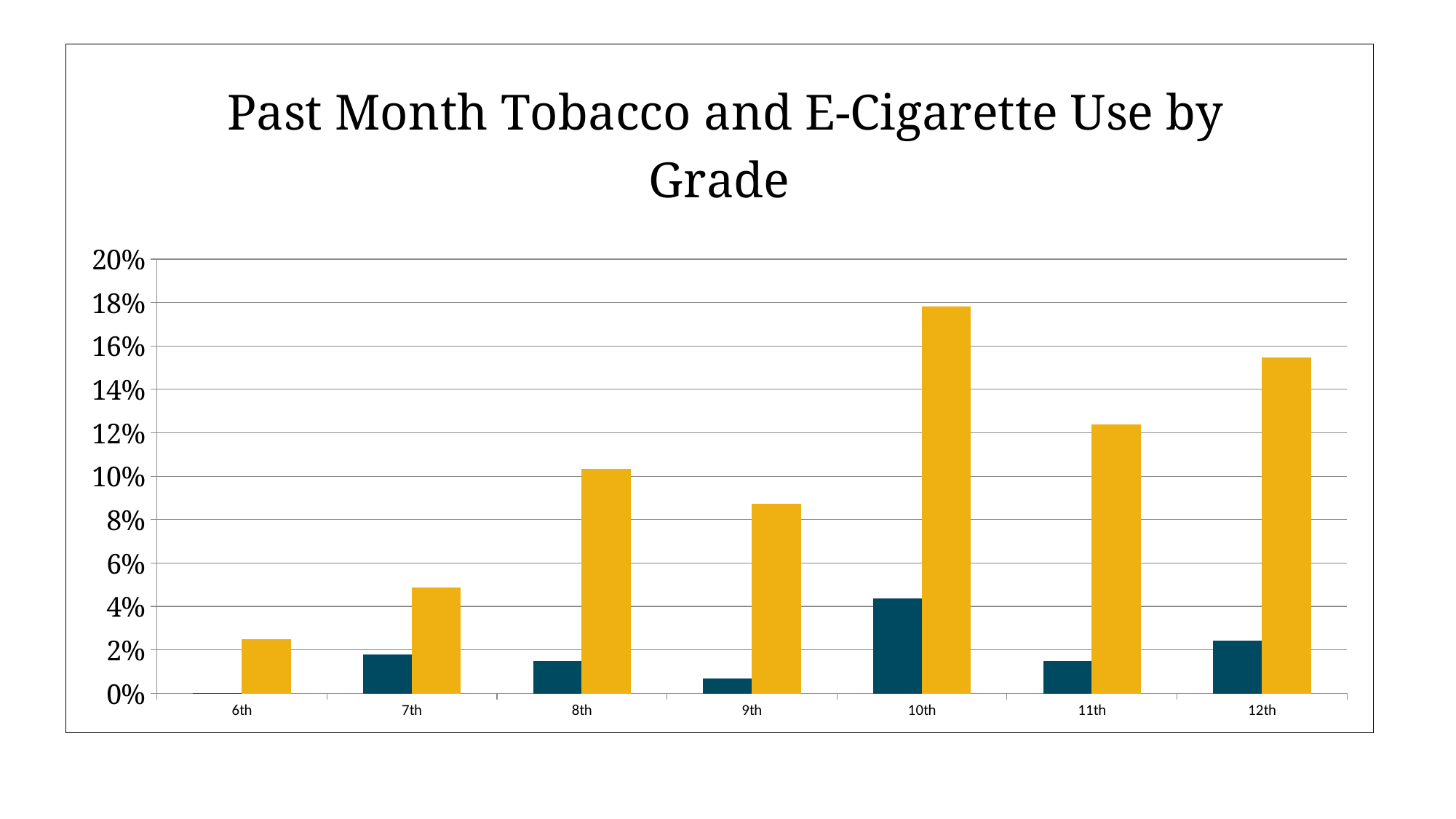
Which grade has the shortest yellow bar? 6th What is the title of the chart? Past Month Tobacco and E-Cigarette Use by Grade Is the yellow bar for 9th grade greater or less than 10%? less Which grade has the tallest dark teal bar? 10th Is the yellow bar for 10th grade greater or less than 16%? greater Which grade has the larger yellow bar, 8th or 9th? 8th How many grade categories are shown on the x axis? 7 Which grade has the larger dark teal bar, 10th or 12th? 10th Which grade has the tallest yellow bar? 10th Is the dark teal bar for 7th grade greater or less than 2%? less What kind of chart is shown on the slide? bar chart